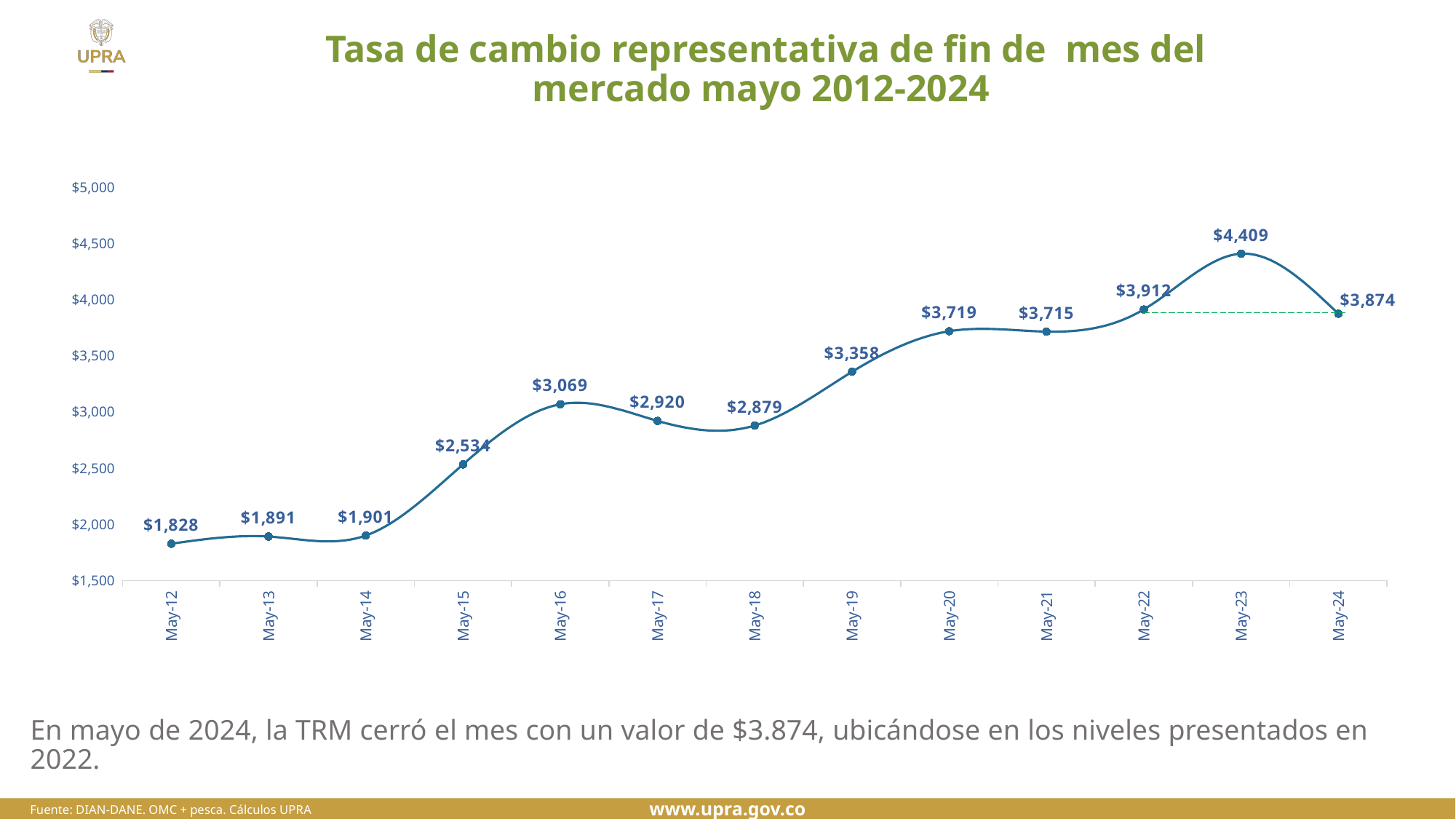
Which point has the highest value? May-23 What is the value for May-16? $3,069 Which is larger, the value for May-17 or the value for May-18? May-17 What is the difference between the values for May-15 and May-14? $633 How many data points are plotted on the chart? 13 What is the difference between the values for May-23 and May-24? $535 Which point has the lowest value? May-12 Is the value for May-19 greater or less than $3,500? less What is the value for May-12? $1,828 What is the value for May-24? $3,874 What kind of chart is shown on the slide? line chart Do the values generally rise or fall from May-12 to May-23? rise